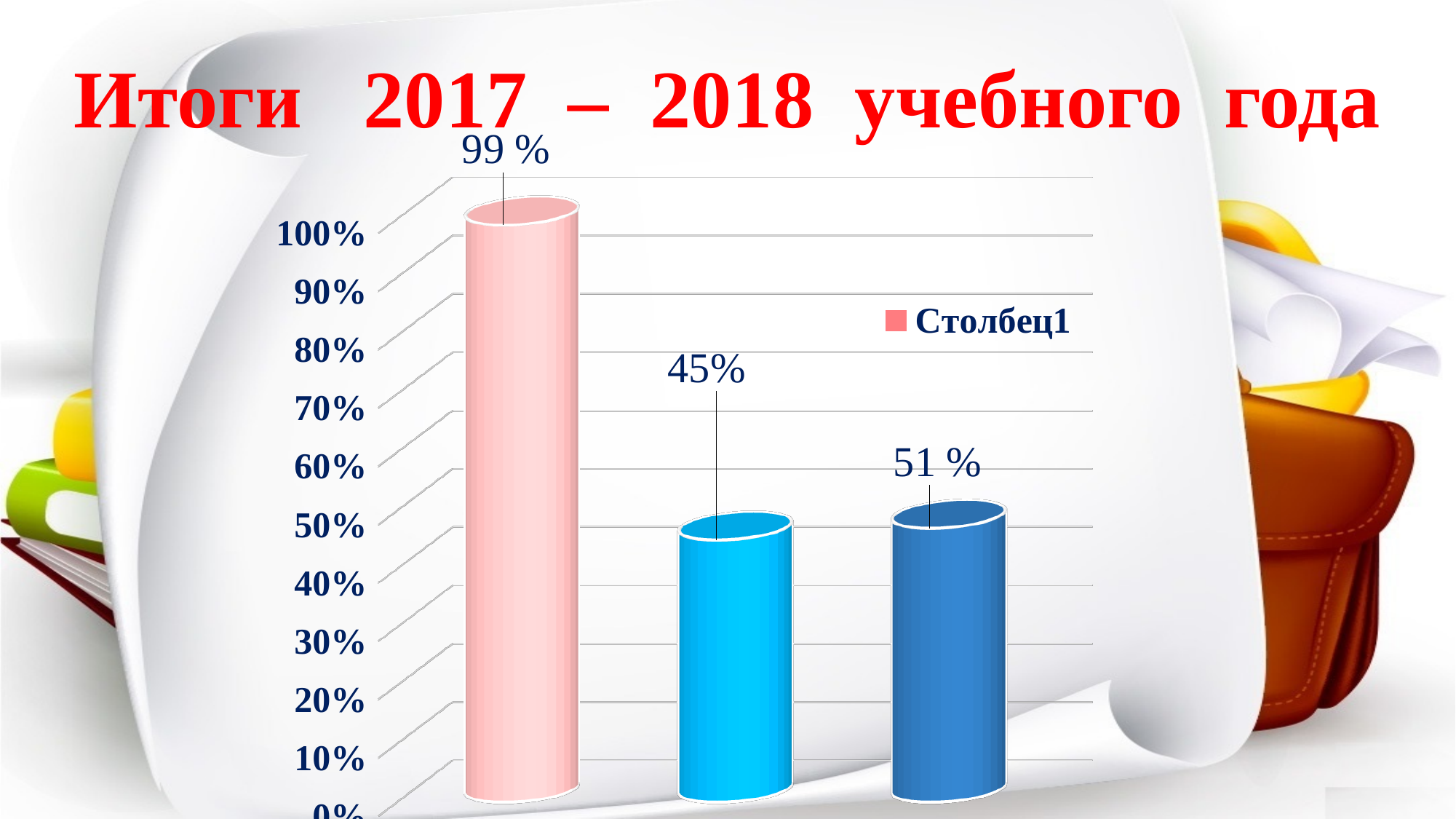
Which bar has the lowest value? The second (light blue) bar, 45% Which bar has the highest value? The first (pink) bar, 99 % What kind of chart is shown on the slide? Bar chart What is the legend entry shown on the chart? Столбец1 What value is labelled on the second (light blue) bar? 45% Which is larger, the second (light blue) bar or the third (dark blue) bar? The third (dark blue) bar How many bars are plotted in the chart? 3 What value is labelled on the first (pink) bar? 99 % How many series does the legend list? 1 What is the difference between the third (dark blue) bar and the second (light blue) bar? 6 percentage points What is the difference between the first (pink) bar and the second (light blue) bar? 54 percentage points What value is labelled on the third (dark blue) bar? 51 %